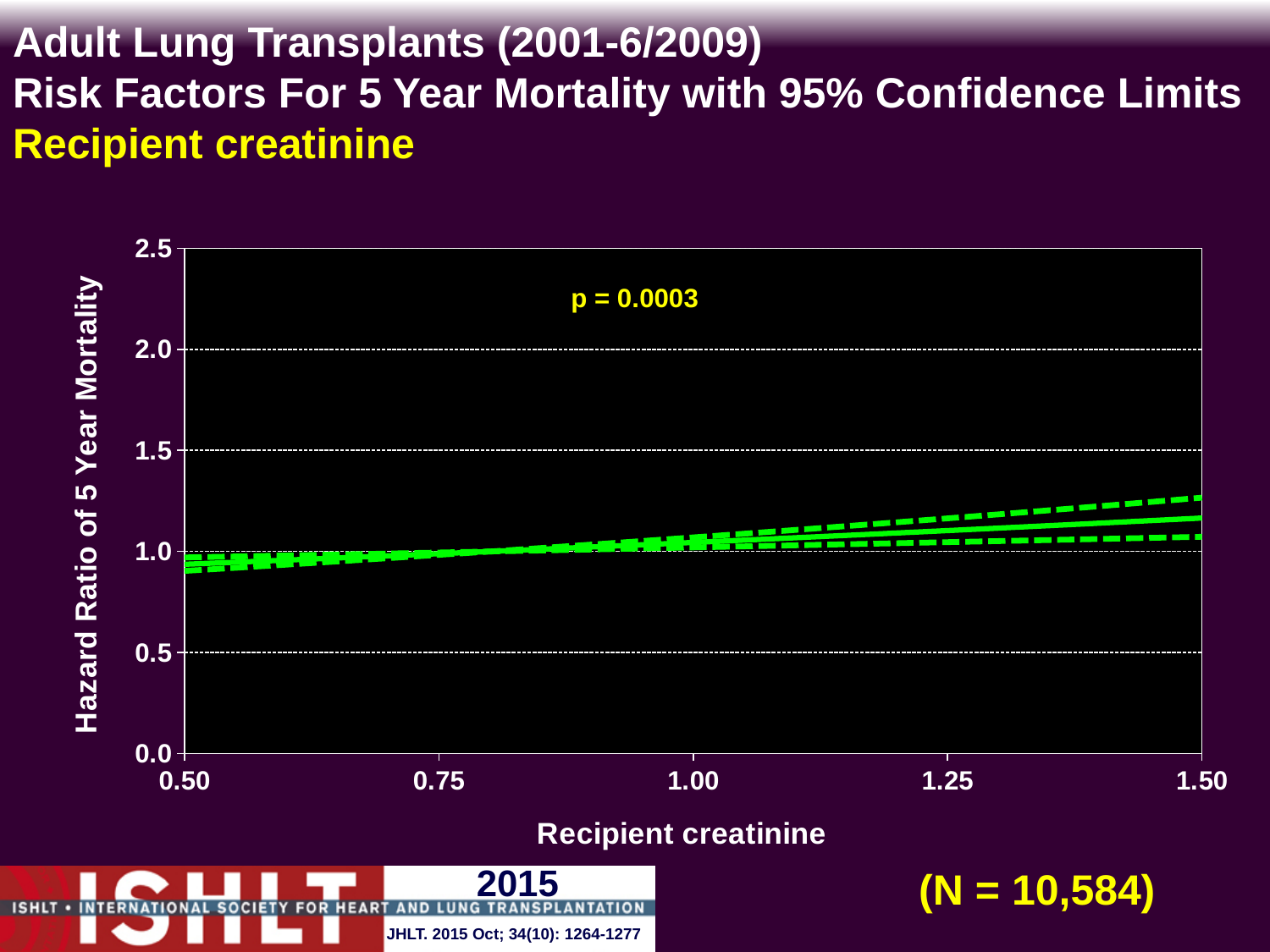
Is the hazard ratio of 5 year mortality at a recipient creatinine of 1.00 greater or less than 1.5? less Does the hazard ratio of 5 year mortality rise or fall as recipient creatinine increases from 0.50 to 1.50? rise Is the hazard ratio of 5 year mortality at a recipient creatinine of 0.50 greater or less than 1.0? less What kind of chart is shown on the slide? line chart Is the upper 95% confidence limit at a recipient creatinine of 1.50 greater or less than 1.5? less What p-value is printed on the chart? p = 0.0003 Which has the higher hazard ratio of 5 year mortality: a recipient creatinine of 0.50 or 1.50? 1.50 How many lines (the estimate plus its confidence limits) are plotted on the chart? 3 What is the highest value shown on the y axis of the chart? 2.5